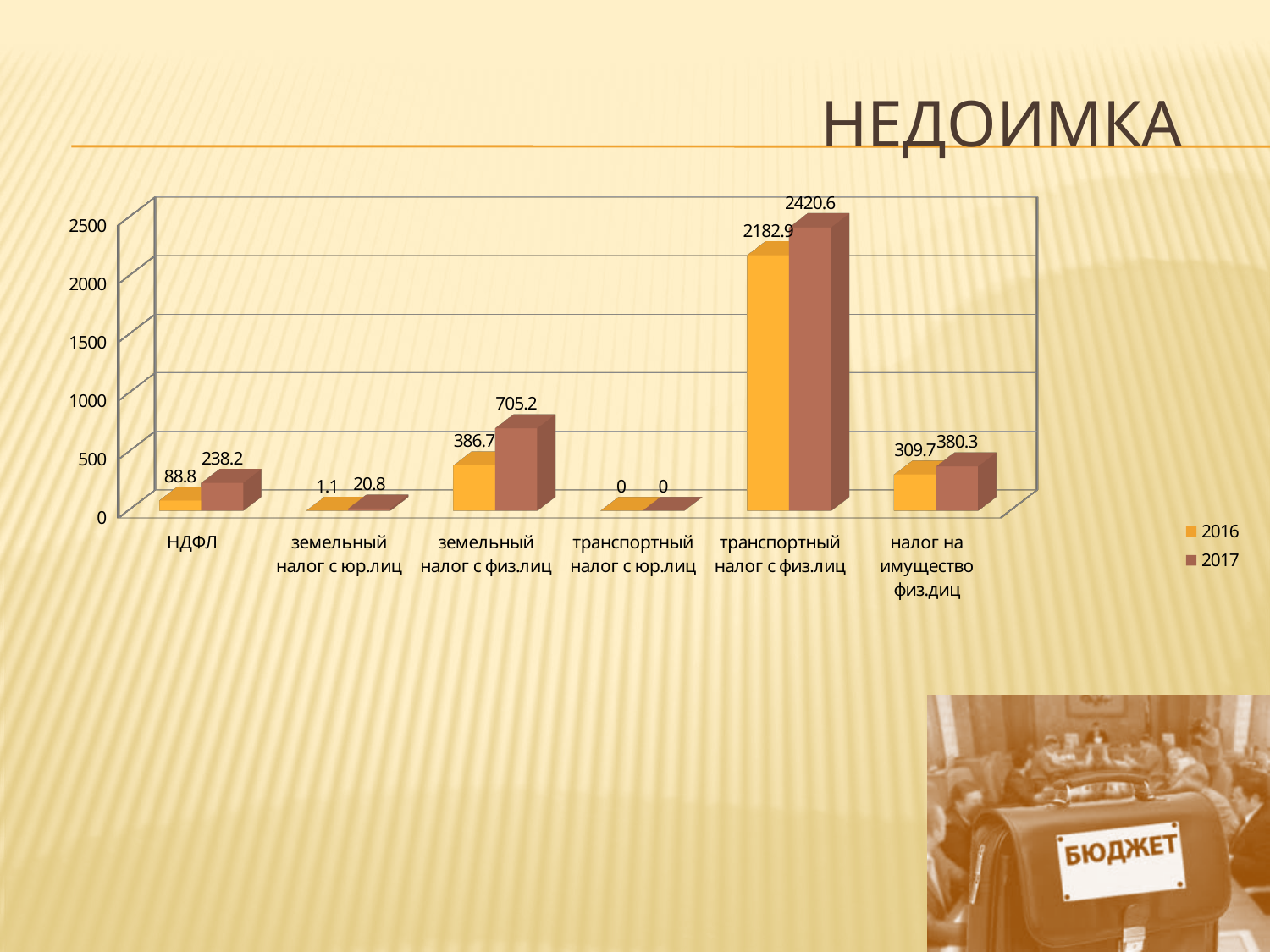
What is the 2017 value for НДФЛ? 238.2 Which category has the highest 2017 value? транспортный налог с физ.лиц What kind of chart is shown on the slide? bar chart How many series does the legend list? 2 Is the 2016 value for транспортный налог с физ.лиц greater or less than 2000? greater Which category has the lowest 2016 value? транспортный налог с юр.лиц What is the 2016 value for налог на имущество физ.лиц? 309.7 What is the 2017 value for транспортный налог с физ.лиц? 2420.6 What is the 2016 value for земельный налог с физ.лиц? 386.7 How many categories are shown on the x axis? 6 Which is larger for НДФЛ: the 2016 value or the 2017 value? 2017 What is the difference between the 2017 and 2016 values for земельный налог с физ.лиц? 318.5